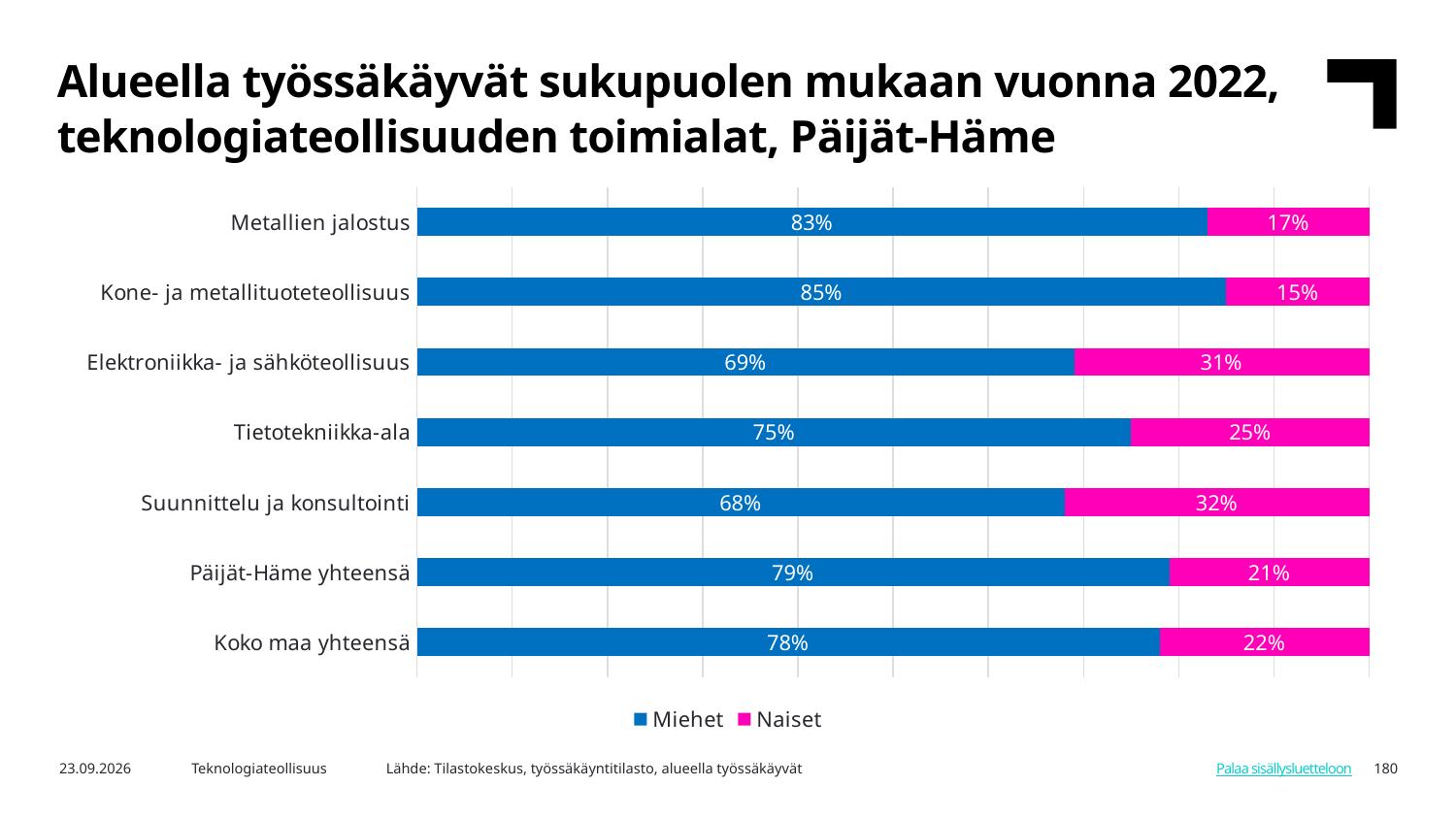
Which category has the highest Naiset share? Suunnittelu ja konsultointi Which category has the lowest Naiset share? Kone- ja metallituoteteollisuus Which is larger: the Naiset share for Tietotekniikka-ala or for Metallien jalostus? Tietotekniikka-ala What is the Miehet share for Metallien jalostus? 83% What is the total of the stacked bar for Suunnittelu ja konsultointi? 100% How many categories are shown on the chart? 7 What is the Naiset share for Elektroniikka- ja sähköteollisuus? 31% What is the difference between the Miehet share for Päijät-Häme yhteensä and Koko maa yhteensä? 1 percentage point What is the Naiset share for Koko maa yhteensä? 22% How many series does the legend list? 2 Which category has the highest Miehet share? Kone- ja metallituoteteollisuus What kind of chart is shown on the slide? Stacked bar chart